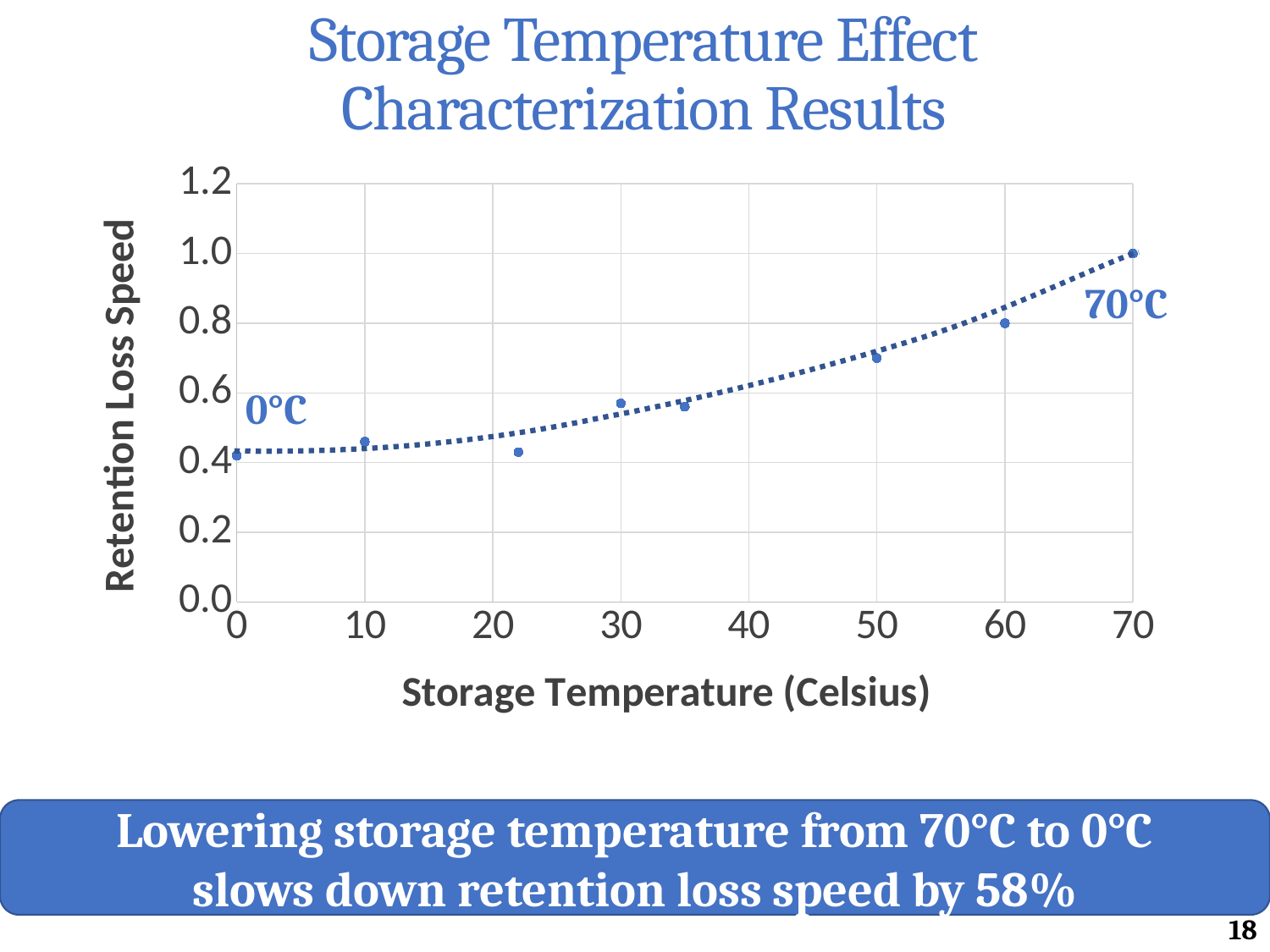
At which storage temperature is the retention loss speed highest? 70 Which has a higher retention loss speed: the point at 50°C or the point at 30°C? 50°C Is the retention loss speed at 0°C greater or less than 0.6? less What kind of chart is shown on the slide? Scatter chart How many data points are plotted on the chart? 8 Is the retention loss speed at 50°C greater or less than 0.6? greater Is the retention loss speed at 60°C greater or less than 0.6? greater What is the label of the x axis? Storage Temperature (Celsius) Does the retention loss speed rise or fall as storage temperature increases along the x axis? Rises Which has a higher retention loss speed: the point at 10°C or the point at 60°C? 60°C What is the label of the y axis? Retention Loss Speed